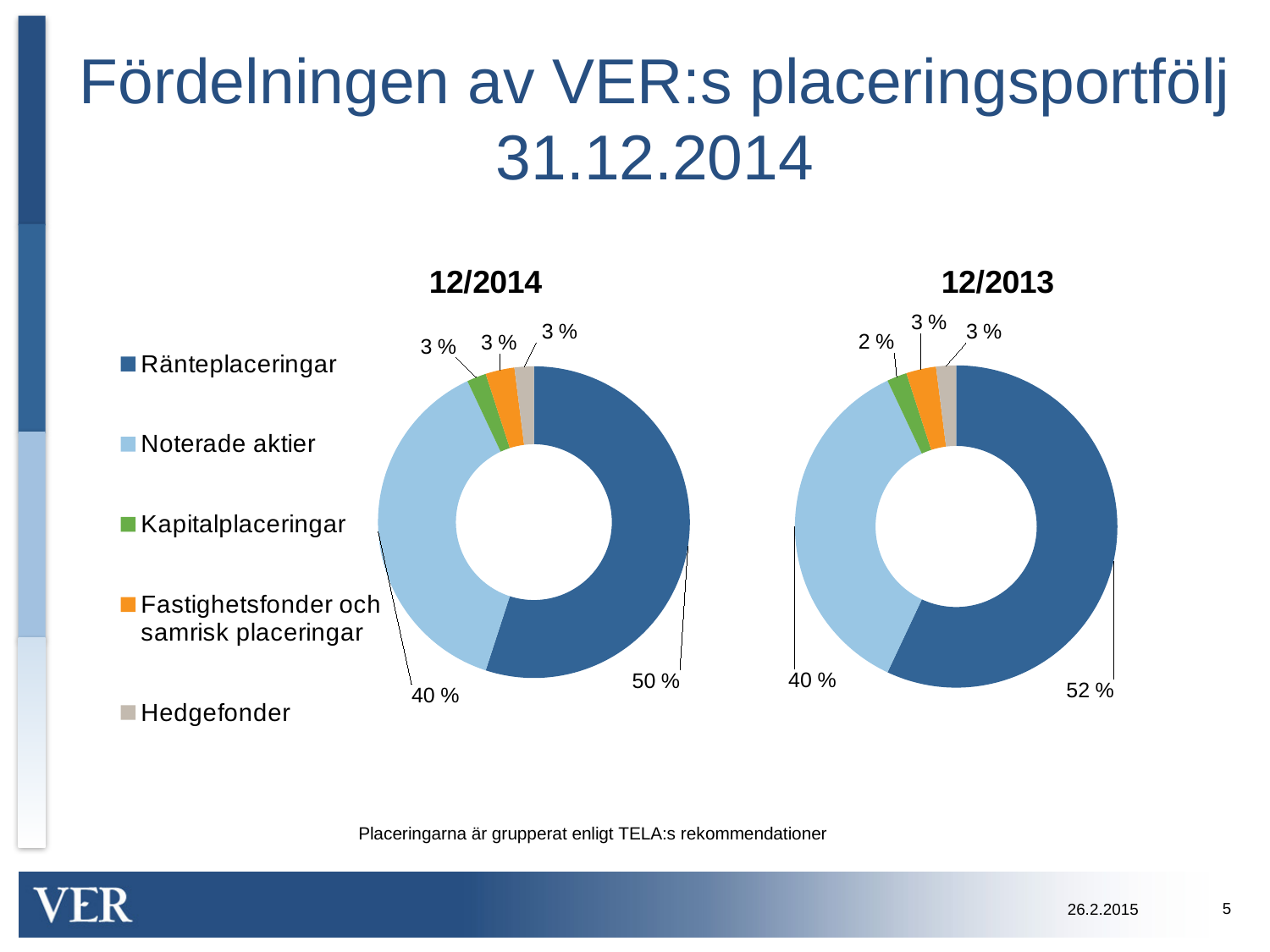
In the 12/2014 chart, what share does Ränteplaceringar have? 50 % In the 12/2014 chart, what share does Noterade aktier have? 40 % In the 12/2014 chart, which is larger: Ränteplaceringar or Noterade aktier? Ränteplaceringar What is the difference between the Ränteplaceringar share in the 12/2013 chart and in the 12/2014 chart? 2 % In the 12/2013 chart, what share does Ränteplaceringar have? 52 % In the 12/2013 chart, which category has the smallest share? Kapitalplaceringar In the 12/2014 chart, which category has the largest share? Ränteplaceringar In the 12/2013 chart, what share does Kapitalplaceringar have? 2 % What is the title of the chart on the right? 12/2013 Which colour represents Hedgefonder in the legend? Grey What kind of chart is used on this slide? Doughnut (pie) chart How many categories does the legend list? 5